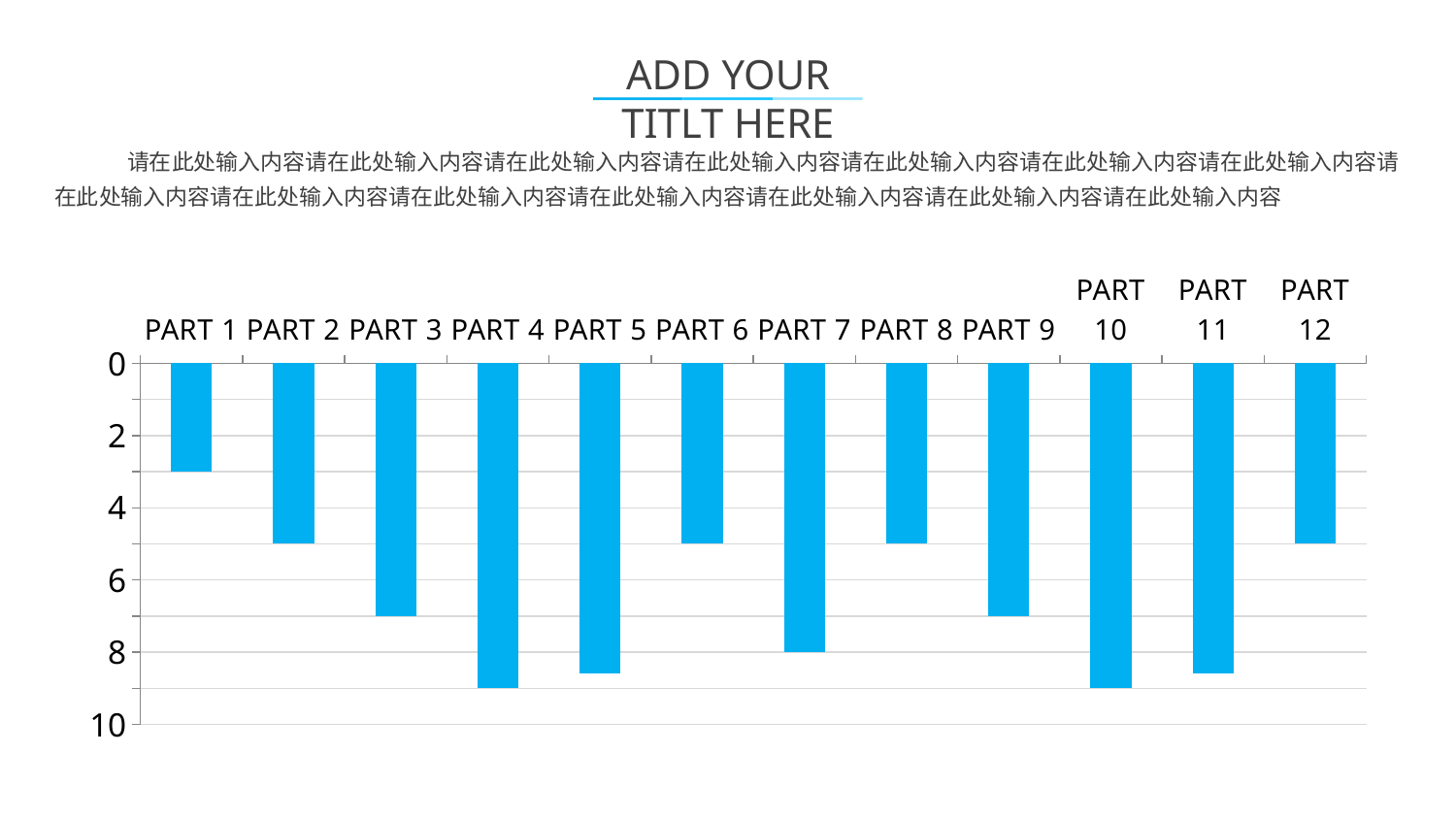
Is the value for PART 3 greater or less than 6? greater Which is larger, the value for PART 5 or the value for PART 8? PART 5 Is the value for PART 4 greater or less than 8? greater Which category has the smallest bar? PART 1 Is the value for PART 1 greater or less than 4? less What kind of chart is shown on the slide? bar chart What colour are the bars in the chart? blue What is the value for PART 7? 8 Which is larger, the value for PART 3 or the value for PART 2? PART 3 How many categories (PART bars) does the chart show? 12